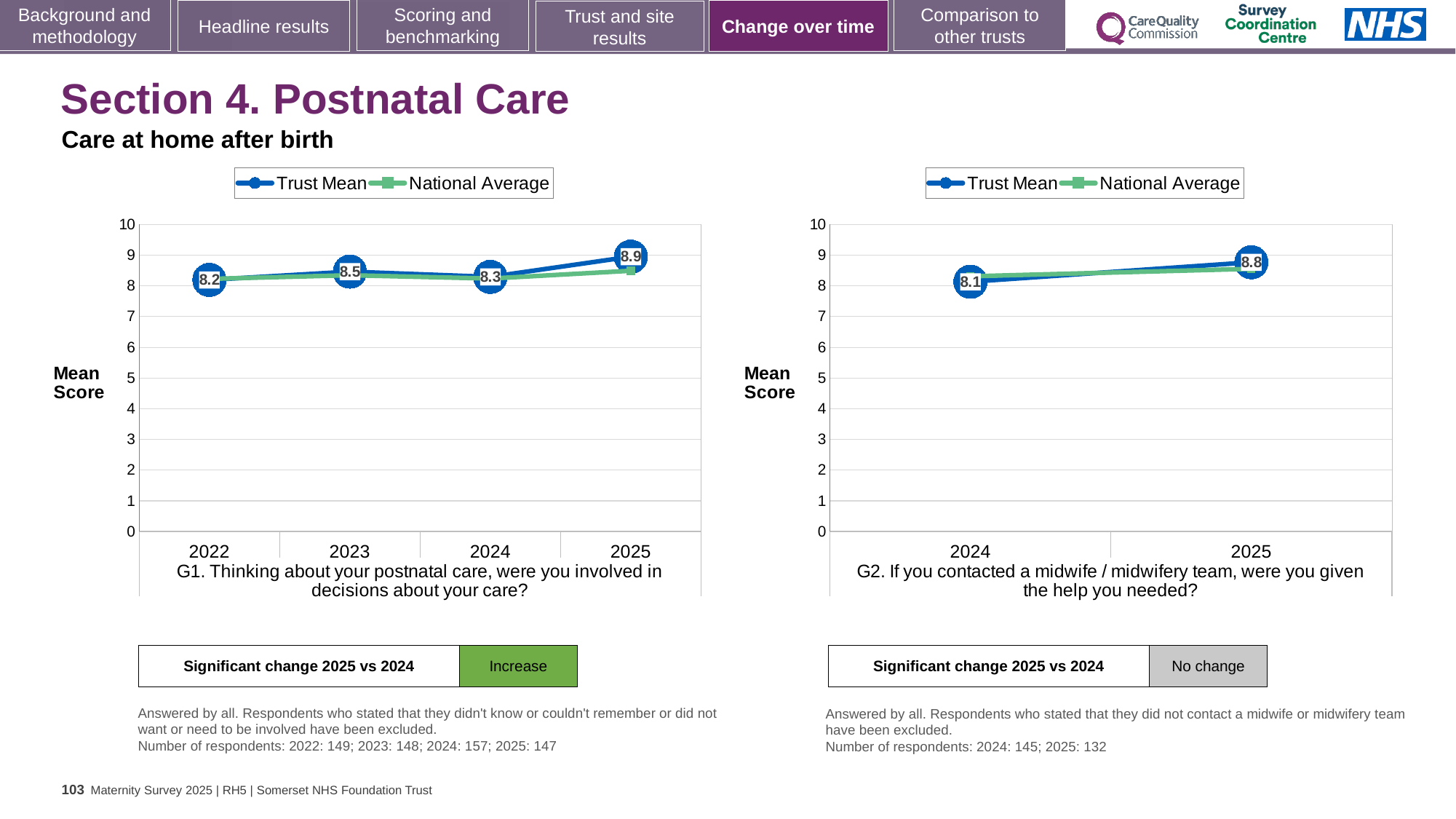
On the left chart (G1), what is the difference between the Trust Mean in 2025 and in 2024? 0.6 On the left chart (G1), how many years are plotted on the x axis? 4 On the right chart (G2), what is the difference between the Trust Mean in 2025 and in 2024? 0.7 On the left chart (G1), is the Trust Mean higher in 2023 or in 2024? 2023 On the right chart (G2), does the Trust Mean rise or fall from 2024 to 2025? rise On the right chart (G2), what is the Trust Mean for 2024? 8.1 On the right chart (G2), how many series does the legend list? 2 On the left chart (G1), what is the Trust Mean for 2022? 8.2 On the left chart (G1), what is the Trust Mean for 2025? 8.9 On the left chart (G1), which year has the highest Trust Mean? 2025 What kind of chart is the left chart (G1)? line chart On the left chart (G1), which year has the lowest Trust Mean? 2022